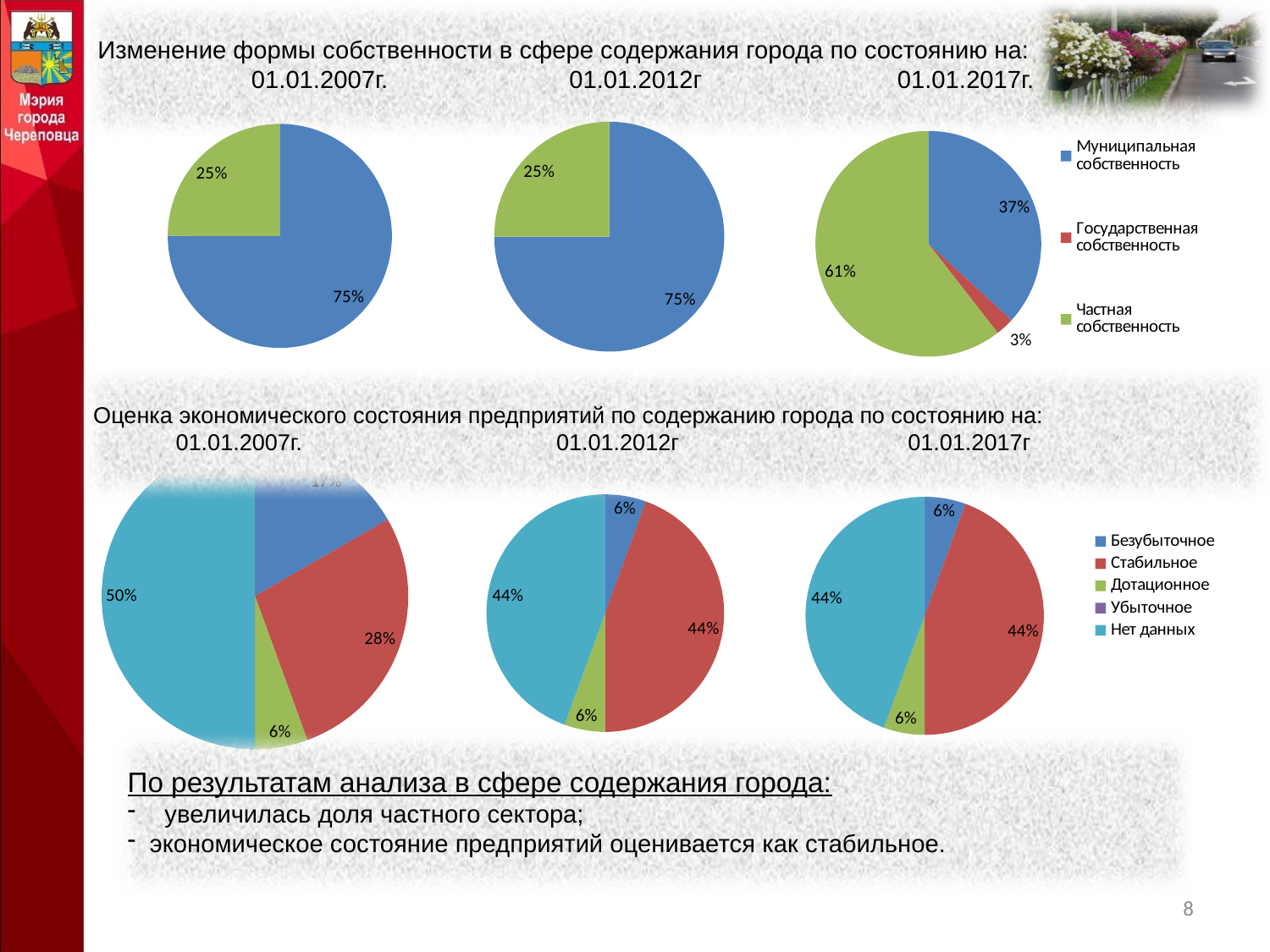
In the bottom-row pie chart for 01.01.2007 (Оценка экономического состояния предприятий), what share is Нет данных? 50% In the top-row pie chart for 01.01.2007 (Изменение формы собственности), what share is Муниципальная собственность? 75% In the top-row pie chart for 01.01.2017 (Изменение формы собственности), what is the difference between the shares of Частная собственность and Муниципальная собственность? 24% In the bottom-row pie chart for 01.01.2012 (Оценка экономического состояния предприятий), what share is Дотационное? 6% What kind of chart is used for the 01.01.2012 chart in the top row (Изменение формы собственности)? Pie chart In the top-row pie chart for 01.01.2017 (Изменение формы собственности), which category has the smallest share? Государственная собственность How many series does the legend of the top-row pie charts (Изменение формы собственности) list? 3 In the top-row pie chart for 01.01.2017 (Изменение формы собственности), which category has the largest share? Частная собственность In the bottom-row pie chart for 01.01.2007 (Оценка экономического состояния предприятий), what share is Стабильное? 28% In the top-row pie chart for 01.01.2017 (Изменение формы собственности), what share is Частная собственность? 61% In the top-row pie chart for 01.01.2017 (Изменение формы собственности), what share is Государственная собственность? 3% How many series does the legend of the bottom-row pie charts (Оценка экономического состояния предприятий) list? 5